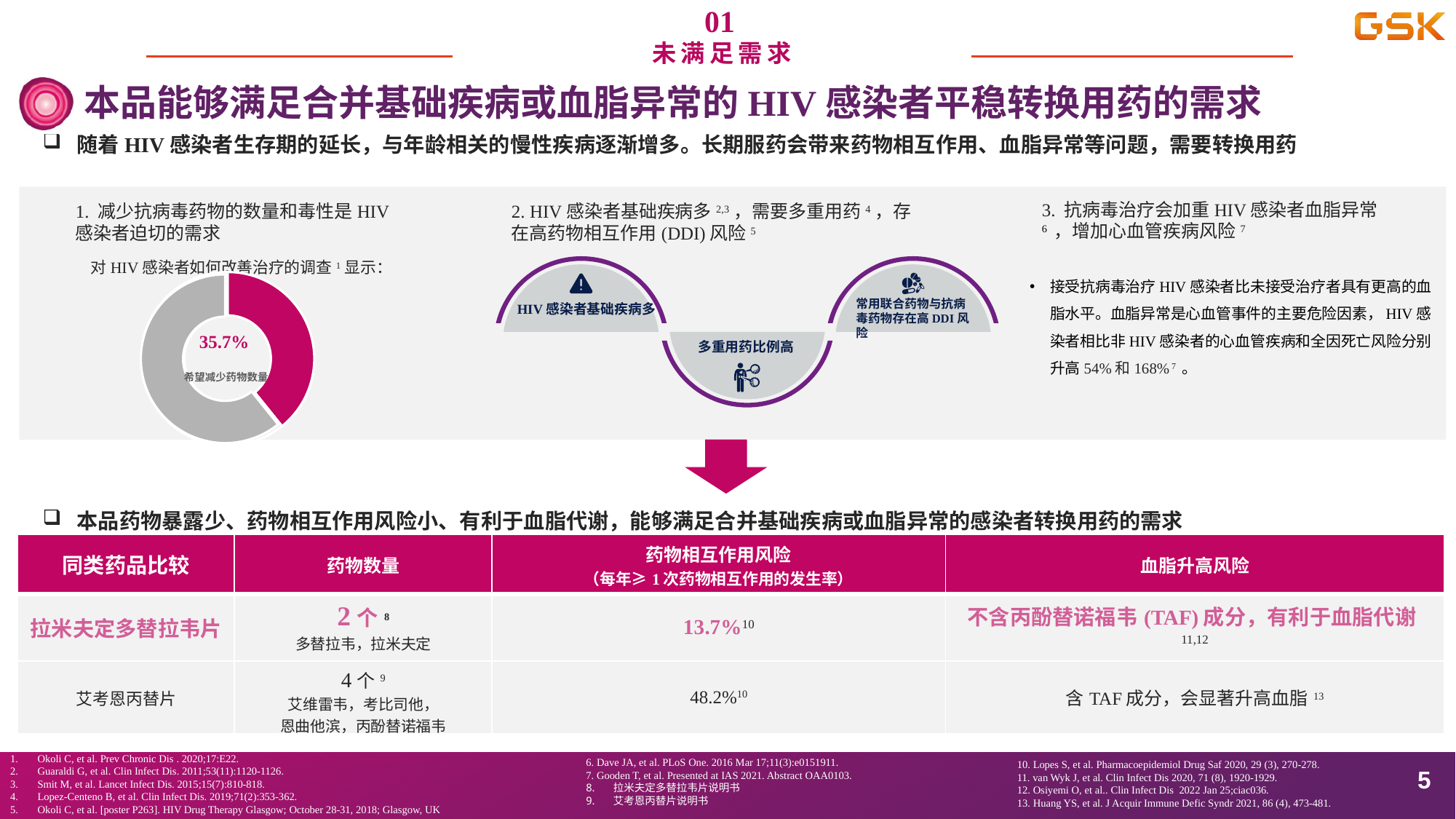
What label is printed inside the donut chart below the 35.7% value? 希望减少药物数量 Is the value for 希望减少药物数量 in the donut chart greater or less than 50%? less In the donut chart, which slice is larger: the magenta 希望减少药物数量 slice or the grey remainder slice? The grey remainder slice What colour is the 希望减少药物数量 slice in the donut chart? Magenta In the donut chart, what percentage of HIV patients wish to reduce the number of drugs (希望减少药物数量)? 35.7% What kind of chart is shown in the left panel under the survey on how HIV patients want to improve treatment? Donut (pie) chart How many slices does the donut chart contain? 2 What share of the donut chart does the 希望减少药物数量 slice represent? 35.7%